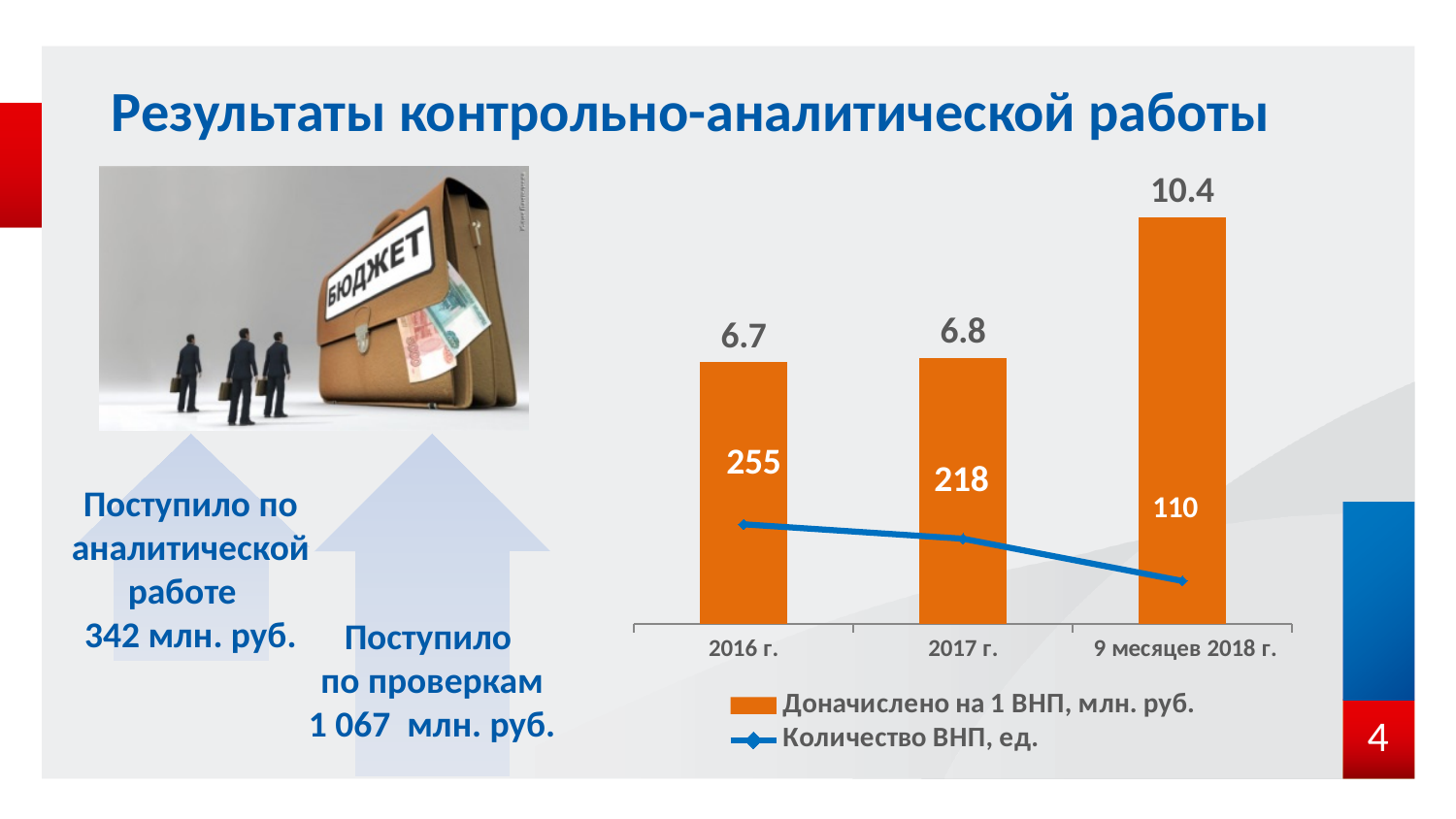
Which period has the highest value of "Доначислено на 1 ВНП, млн. руб."? 9 месяцев 2018 г. How many series does the chart legend list? 2 What is the value of "Количество ВНП, ед." for 9 месяцев 2018 г.? 110 What is the difference in "Доначислено на 1 ВНП, млн. руб." between 9 месяцев 2018 г. and 2017 г.? 3.6 What is the value of "Количество ВНП, ед." for 2017 г.? 218 How many periods are shown on the x axis of the chart? 3 What is the difference in "Количество ВНП, ед." between 2016 г. and 2017 г.? 37 What is the value of "Доначислено на 1 ВНП, млн. руб." for 9 месяцев 2018 г.? 10.4 Which period has the lowest value of "Количество ВНП, ед."? 9 месяцев 2018 г. Which is larger, "Количество ВНП, ед." in 2016 г. or in 9 месяцев 2018 г.? 2016 г. Does "Количество ВНП, ед." rise or fall from 2016 г. to 9 месяцев 2018 г.? fall What is the value of "Доначислено на 1 ВНП, млн. руб." for 2016 г.? 6.7